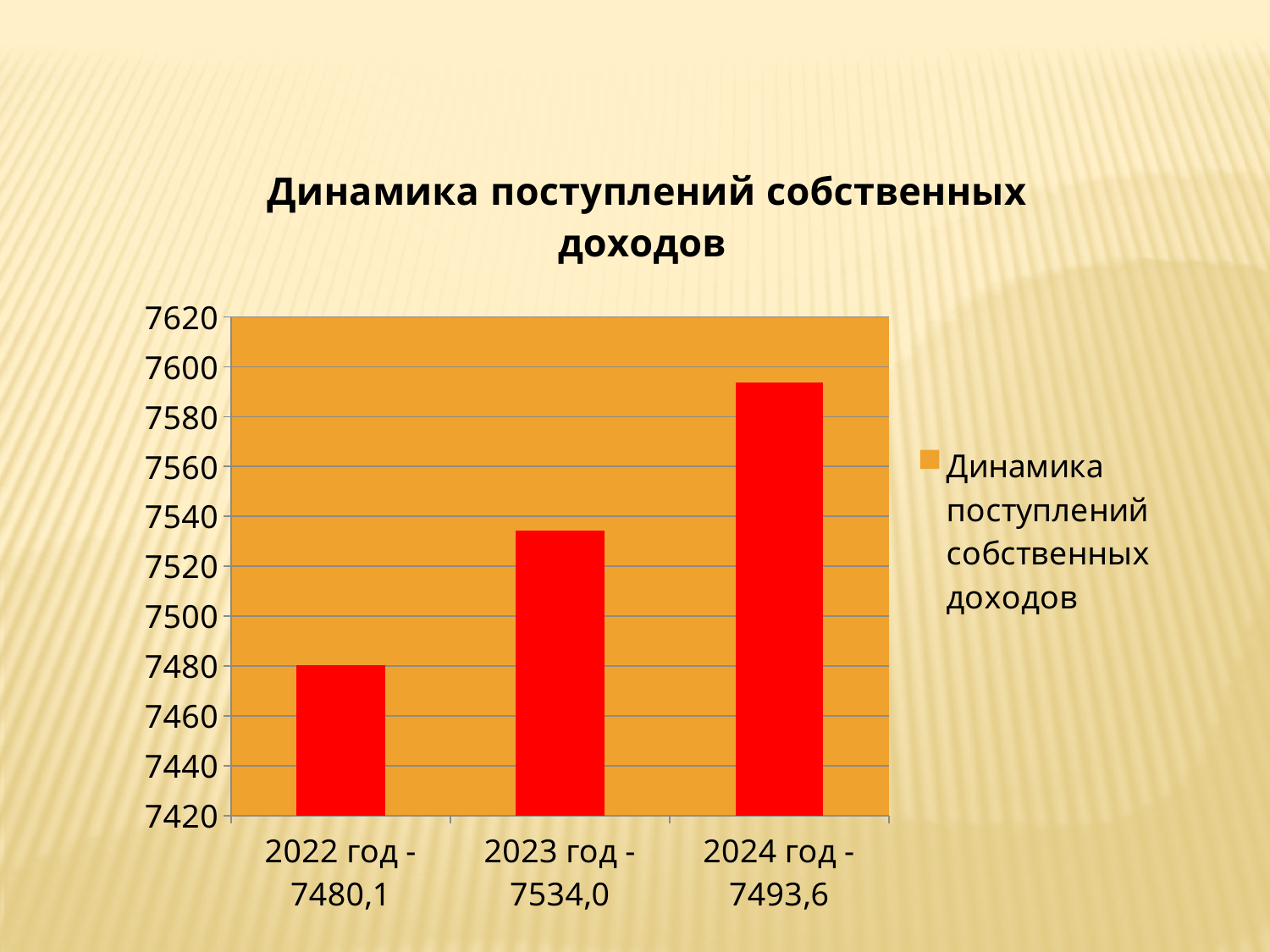
What type of chart is shown on the slide? bar chart What value is given for 2023 год? 7534,0 Is the value for 2023 год greater or less than 7520? greater What is the difference between the values for 2023 год and 2022 год? 53,9 What colour are the bars in the chart? red How many series does the legend list? 1 What value is given for 2022 год? 7480,1 Which year has the lowest bar? 2022 год How many categories (years) are shown on the x axis? 3 Is the value for 2022 год greater or less than 7500? less Which is larger, the value for 2022 год or for 2023 год? 2023 год What is the title of the chart? Динамика поступлений собственных доходов